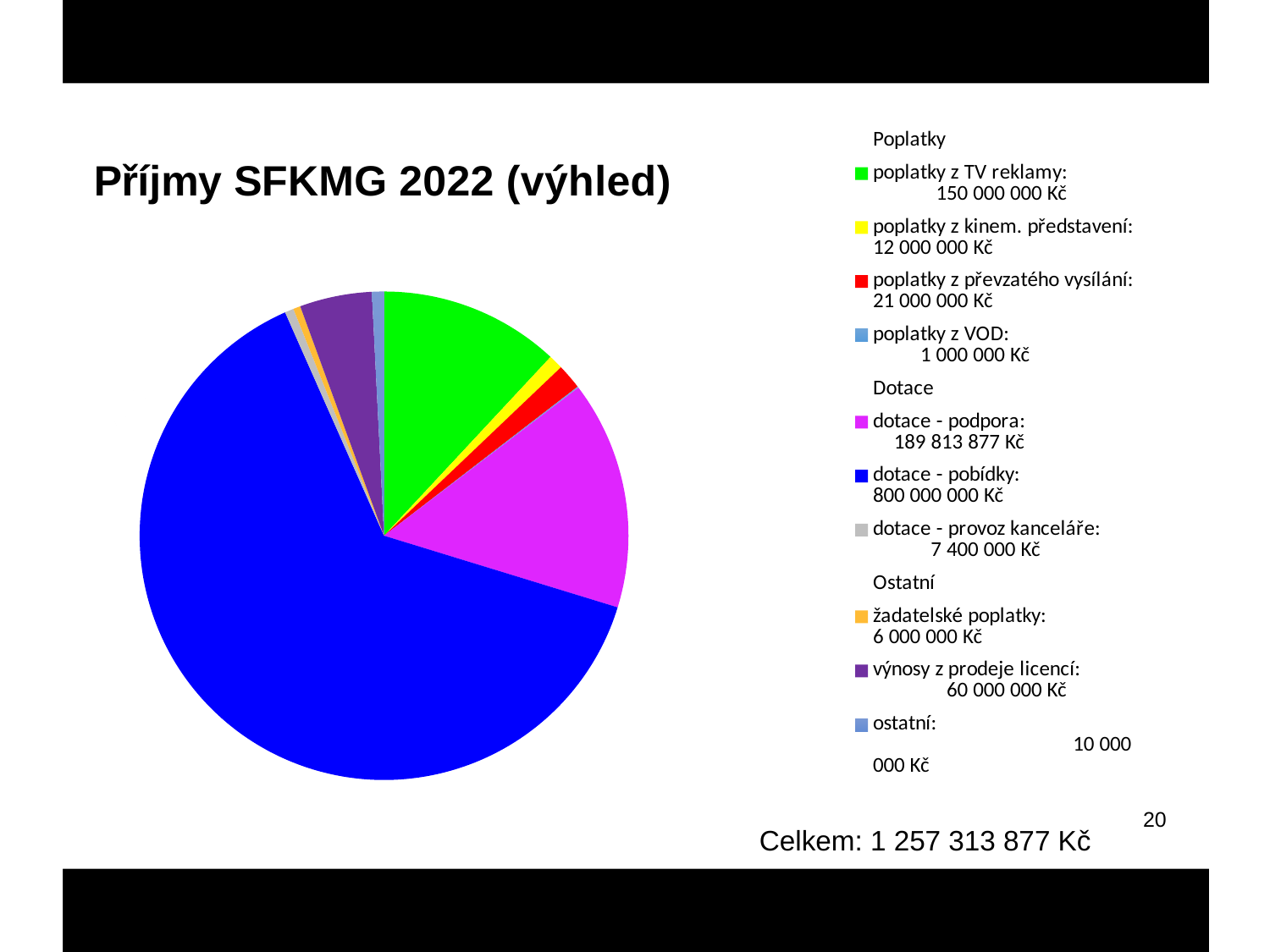
What is the value for poplatky z VOD? 1 000 000 Kč What is the value for výnosy z prodeje licencí? 60 000 000 Kč What is the total (Celkem) shown on the slide? 1 257 313 877 Kč What type of chart is shown on the slide? pie chart Which is larger, poplatky z převzatého vysílání or poplatky z kinem. představení? poplatky z převzatého vysílání What is the difference between poplatky z TV reklamy and výnosy z prodeje licencí? 90 000 000 Kč Which category has the smallest value? poplatky z VOD What is the title of the chart? Příjmy SFKMG 2022 (výhled) What is the value for dotace - podpora? 189 813 877 Kč Which category has the largest slice of the pie? dotace - pobídky How many slices does the pie chart have? 10 What is the value for poplatky z TV reklamy? 150 000 000 Kč